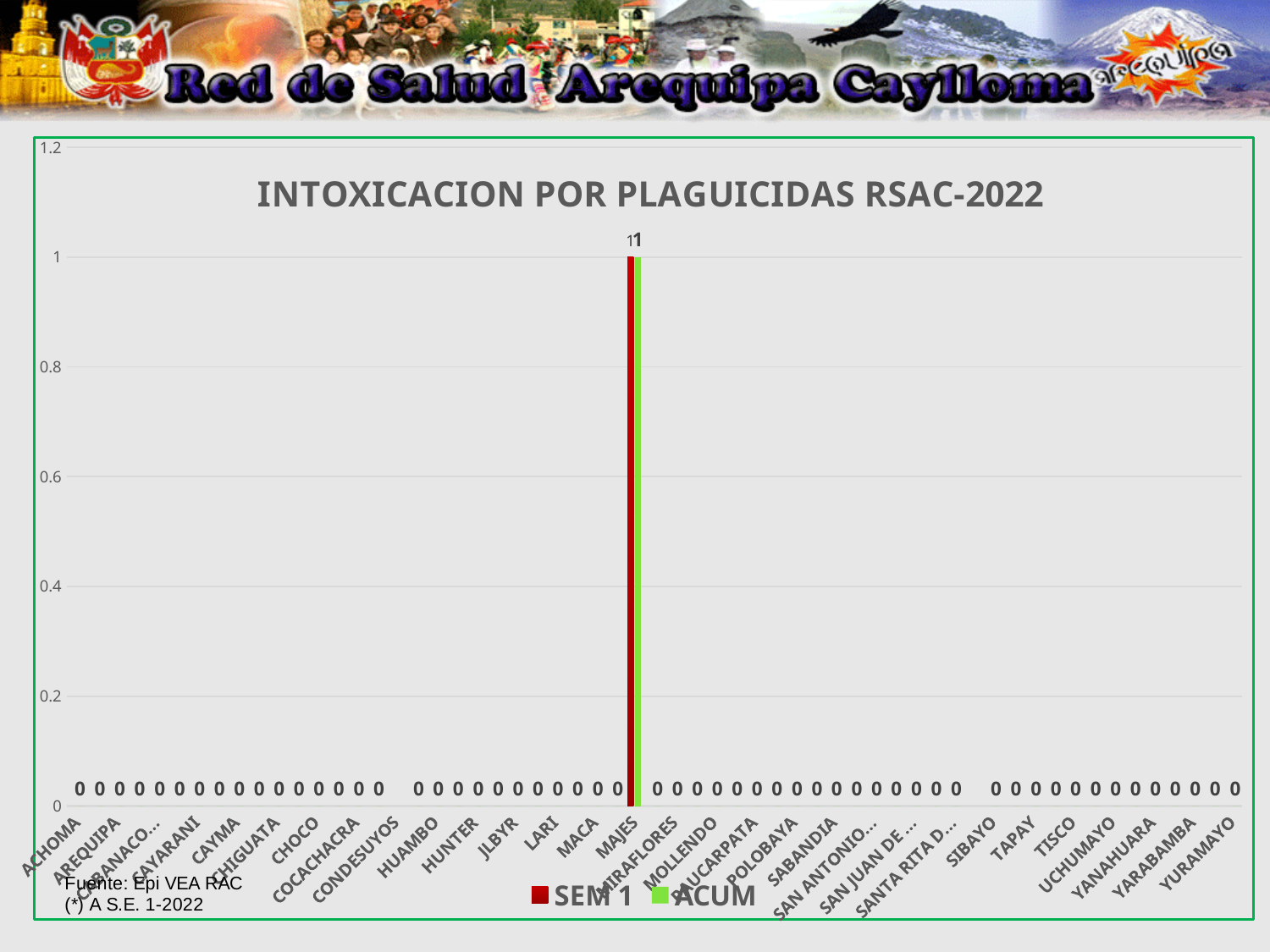
Which is larger, the ACUM value for MAJES or the ACUM value for HUNTER? MAJES How many series does the legend list? 2 Which category has the highest ACUM value? MAJES What is the difference between the ACUM value for MAJES and the ACUM value for MOLLENDO? 1 What is the SEM 1 value for MAJES? 1 What is the ACUM value for MAJES? 1 What are the two series named in the legend? SEM 1 and ACUM What is the title of the chart? INTOXICACION POR PLAGUICIDAS RSAC-2022 What is the ACUM value for CAYMA? 0 What kind of chart is shown on the slide? bar chart